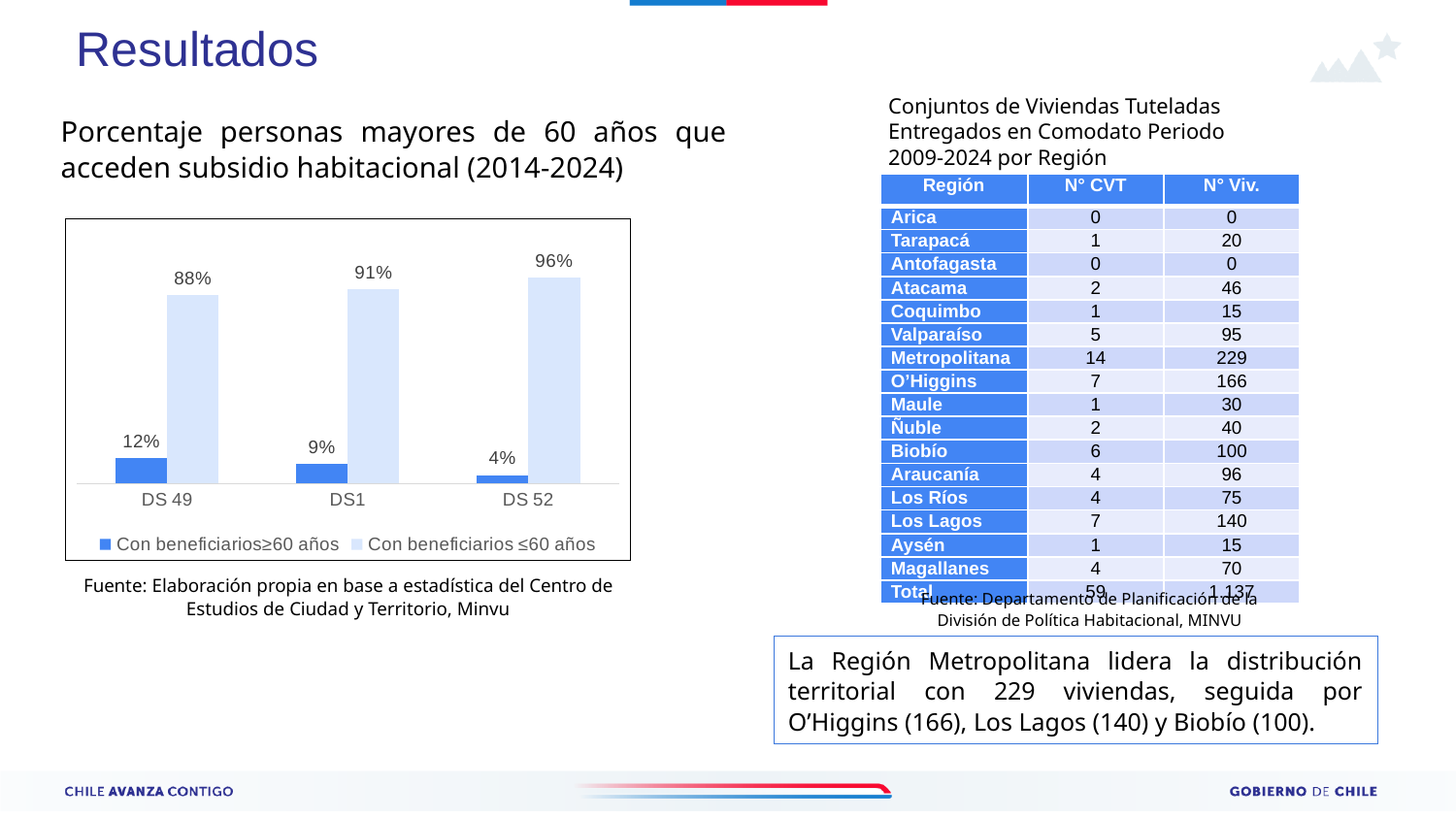
What is the difference between the 'Con beneficiarios≥60 años' values for DS 49 and DS 52? 8% Which category has the highest value for 'Con beneficiarios≥60 años'? DS 49 Which category has the lowest value for 'Con beneficiarios ≤60 años'? DS 49 How many series does the chart legend list? 2 How many categories are shown on the x axis of the chart? 3 What is the value for 'Con beneficiarios ≤60 años' for DS 52? 96% Which is larger: the 'Con beneficiarios≥60 años' value for DS1 or for DS 52? DS1 Which series is shown in the darker blue colour in the chart? Con beneficiarios≥60 años What is the value for 'Con beneficiarios ≤60 años' for DS1? 91% What type of chart is shown on the slide? bar chart What is the value for 'Con beneficiarios≥60 años' for DS 49? 12% What is the value for 'Con beneficiarios≥60 años' for DS 52? 4%